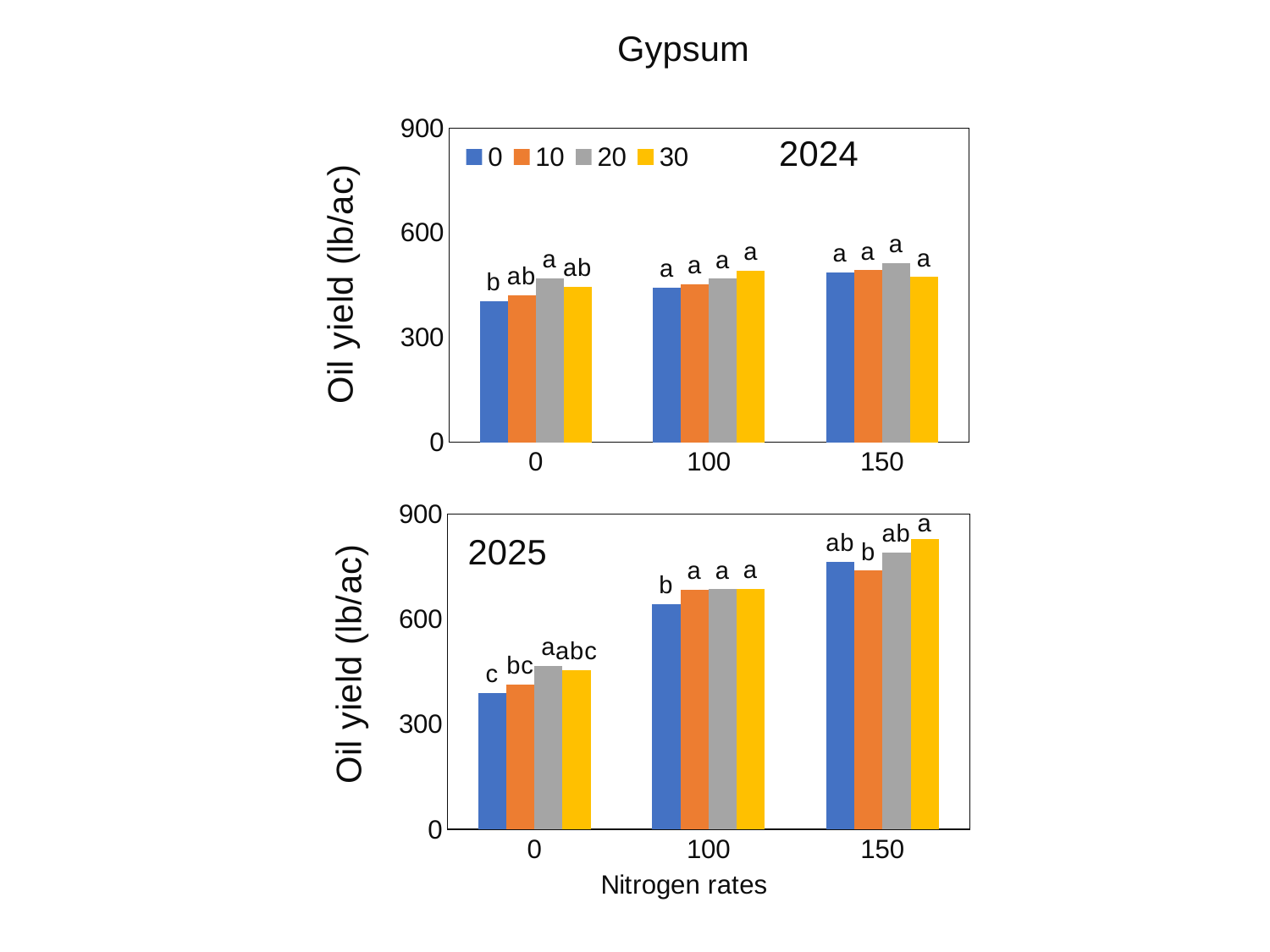
In the 2025 chart, is the value for gypsum rate 30 at nitrogen rate 150 greater or less than 600? greater What kind of chart is the 2024 chart? bar chart What is the y-axis label on the 2025 chart? Oil yield (lb/ac) In the 2025 chart, is the value for gypsum rate 0 at nitrogen rate 100 greater or less than 600? greater How many nitrogen rate categories are shown on the x axis of the 2025 chart? 3 In the 2025 chart, which gypsum rate has the lowest oil yield at nitrogen rate 0? 0 What is the title shown above the charts? Gypsum In the 2025 chart, which gypsum rate has the highest oil yield at nitrogen rate 150? 30 How many series does the legend on the 2024 chart list? 4 In the 2024 chart, is the value for gypsum rate 0 at nitrogen rate 0 greater or less than 300? greater In the 2025 chart, does the oil yield for gypsum rate 0 rise or fall as the nitrogen rate increases from 0 to 150? rise